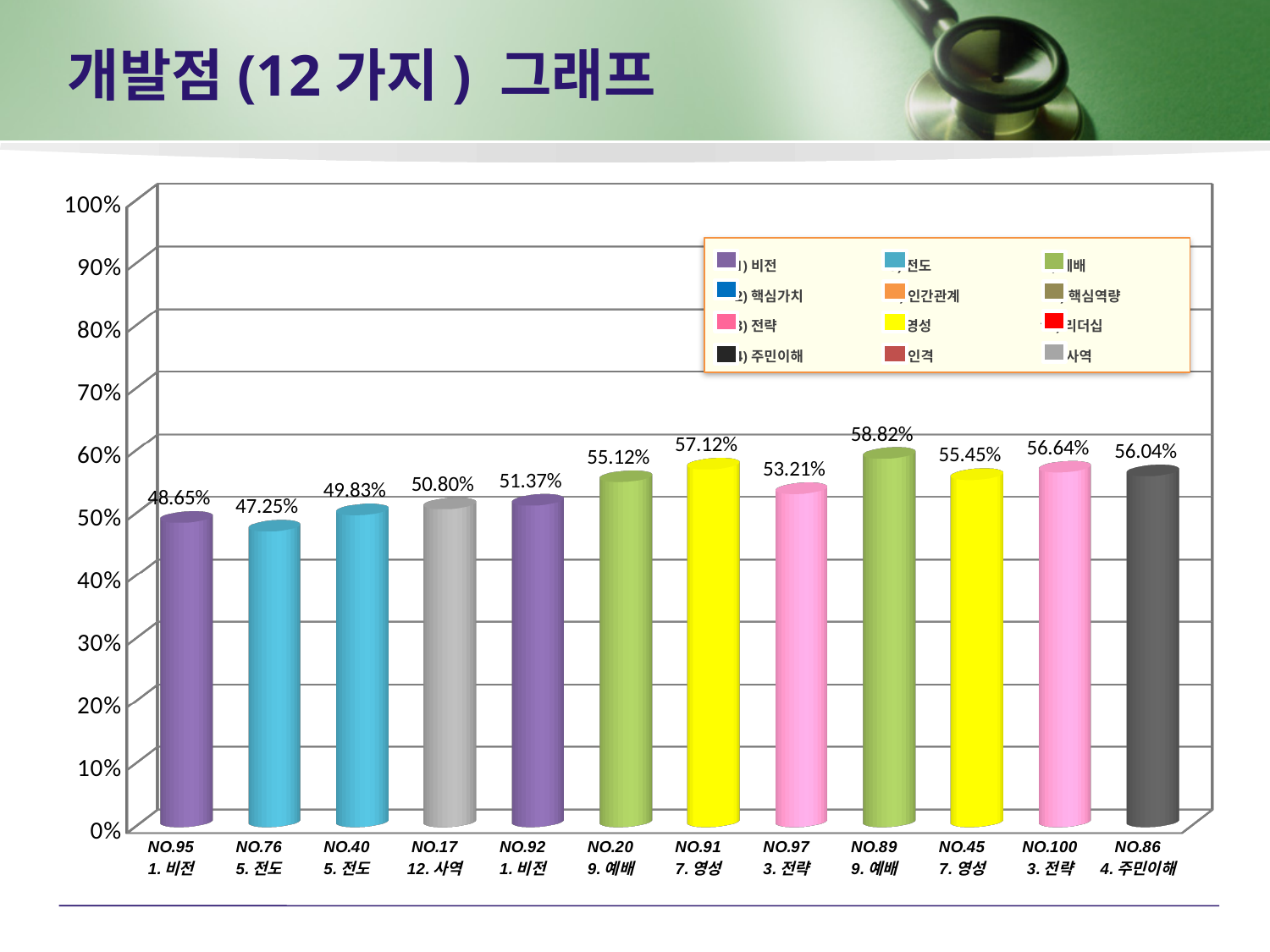
What is the value for NO.86 (4. 주민이해)? 56.04% What is the value for NO.17 (12. 사역)? 50.80% Is the value for NO.95 (1. 비전) greater or less than 50%? less Which is larger, the value for NO.100 (3. 전략) or the value for NO.45 (7. 영성)? NO.100 (3. 전략) Which category has the lowest value? NO.76 (5. 전도) What is the value for NO.89 (9. 예배)? 58.82% Which category has the highest value? NO.89 (9. 예배) What is the value for NO.76 (5. 전도)? 47.25% What is the difference between the values for NO.91 (7. 영성) and NO.97 (3. 전략)? 3.91% What is the title of the slide containing the chart? 개발점 (12 가지 ) 그래프 How many bars are plotted in the chart? 12 What kind of chart is shown on the slide? bar chart